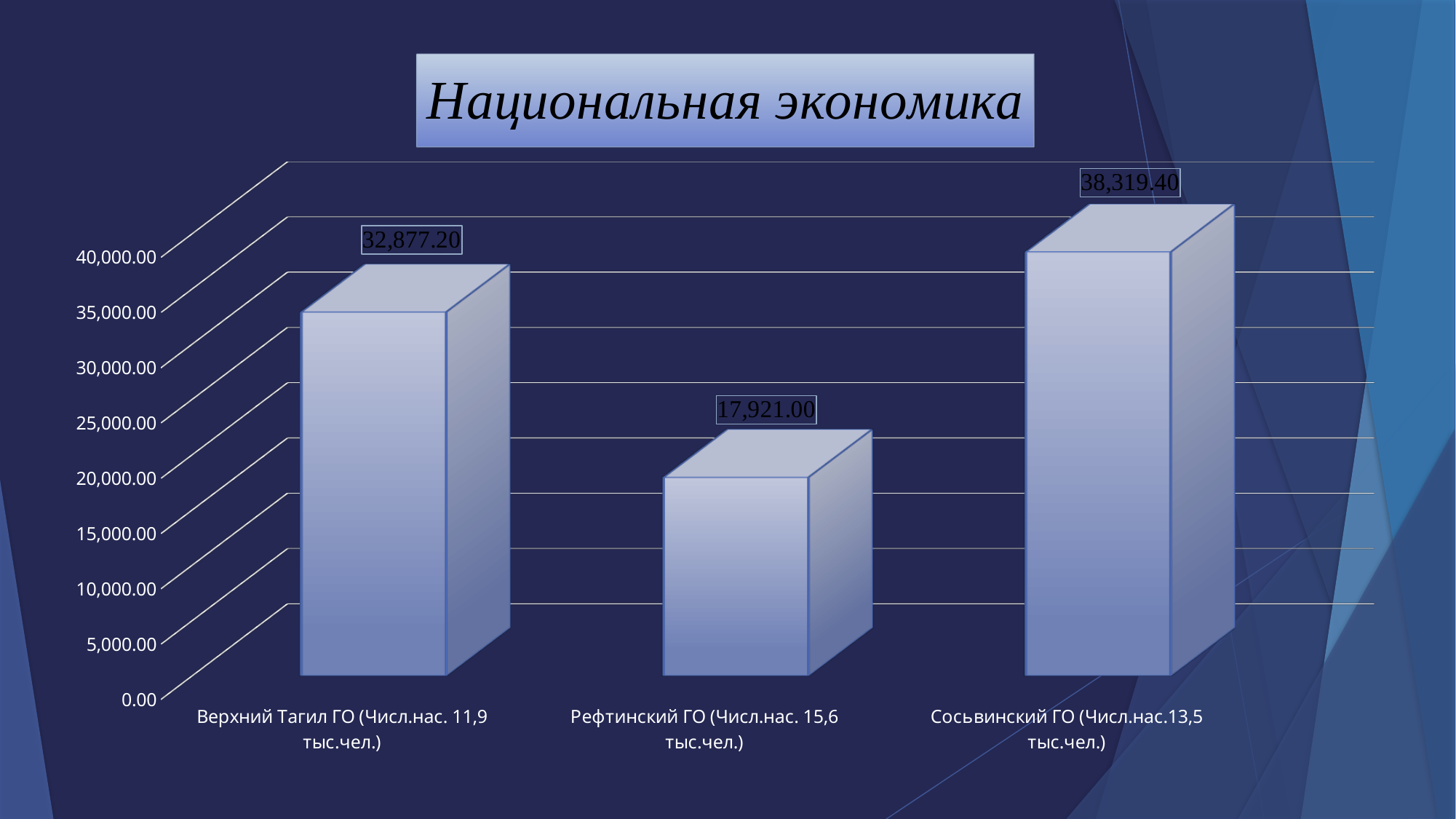
What is the difference between the values for Верхний Тагил ГО and Рефтинский ГО? 14,956.20 Is the value for Рефтинский ГО greater or less than 20,000.00? less Which category has the highest value? Сосьвинский ГО What is the title of the slide? Национальная экономика What is the difference between the values for Сосьвинский ГО and Верхний Тагил ГО? 5,442.20 Which category has the lowest value? Рефтинский ГО What is the value for Рефтинский ГО? 17,921.00 What kind of chart is shown on the slide? bar chart What is the value for Сосьвинский ГО? 38,319.40 Which is larger, the value for Верхний Тагил ГО or the value for Рефтинский ГО? Верхний Тагил ГО What is the value for Верхний Тагил ГО? 32,877.20 How many categories are shown in the chart? 3